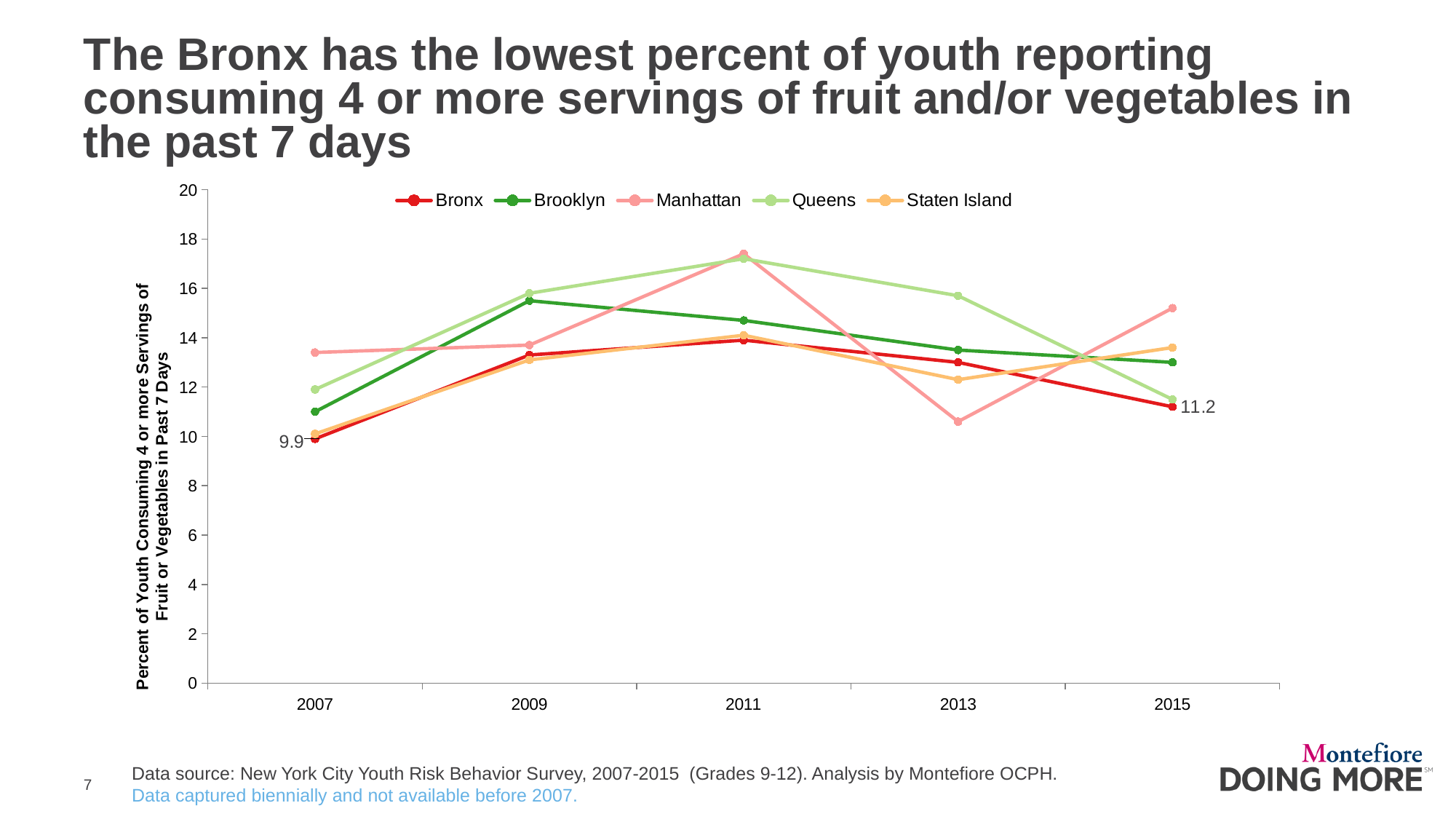
What is the difference between the Bronx's 2015 value and its 2007 value? 1.3 How many years are shown on the x axis? 5 What kind of chart is shown on the slide? line chart Which borough has the lowest value in 2015? Bronx How many series does the legend list? 5 Which is larger in 2015, the value for Manhattan or the value for Queens? Manhattan Which borough is shown with a red line? Bronx Which borough has the lowest value in 2013? Manhattan Is the value for Brooklyn in 2007 greater or less than 12? less Is the value for Queens in 2011 greater or less than 16? greater What is the value for the Bronx in 2007? 9.9 What is the value for the Bronx in 2015? 11.2